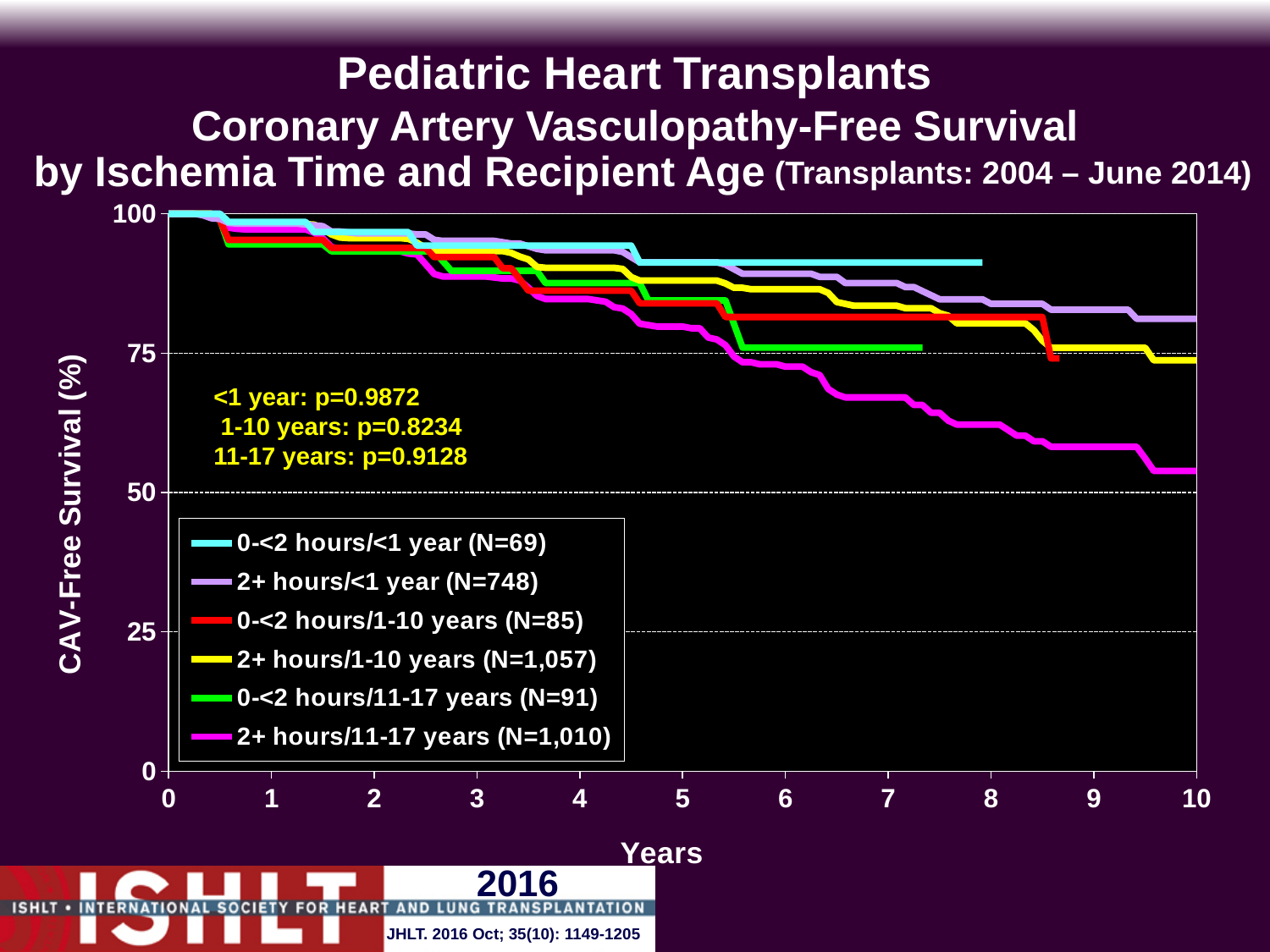
Is the CAV-free survival for the 2+ hours/11-17 years series at 10 years greater or less than 75? less Is the CAV-free survival for the 2+ hours/<1 year series at 10 years greater or less than 75? greater What is the N shown in the legend for the 2+ hours/1-10 years series? N=1,057 Is the CAV-free survival for the 2+ hours/11-17 years series at 10 years greater or less than 50? greater Which series has the highest CAV-free survival at 10 years? 2+ hours/<1 year (N=748) Which series has the lowest CAV-free survival at 10 years? 2+ hours/11-17 years (N=1,010) At 5 years, which series has higher CAV-free survival: 0-<2 hours/<1 year or 2+ hours/11-17 years? 0-<2 hours/<1 year What kind of chart is shown on the slide? line chart What p-value is shown on the chart for the <1 year comparison? p=0.9872 Do the CAV-free survival curves rise or fall as years since transplant increase? fall How many series does the legend list? 6